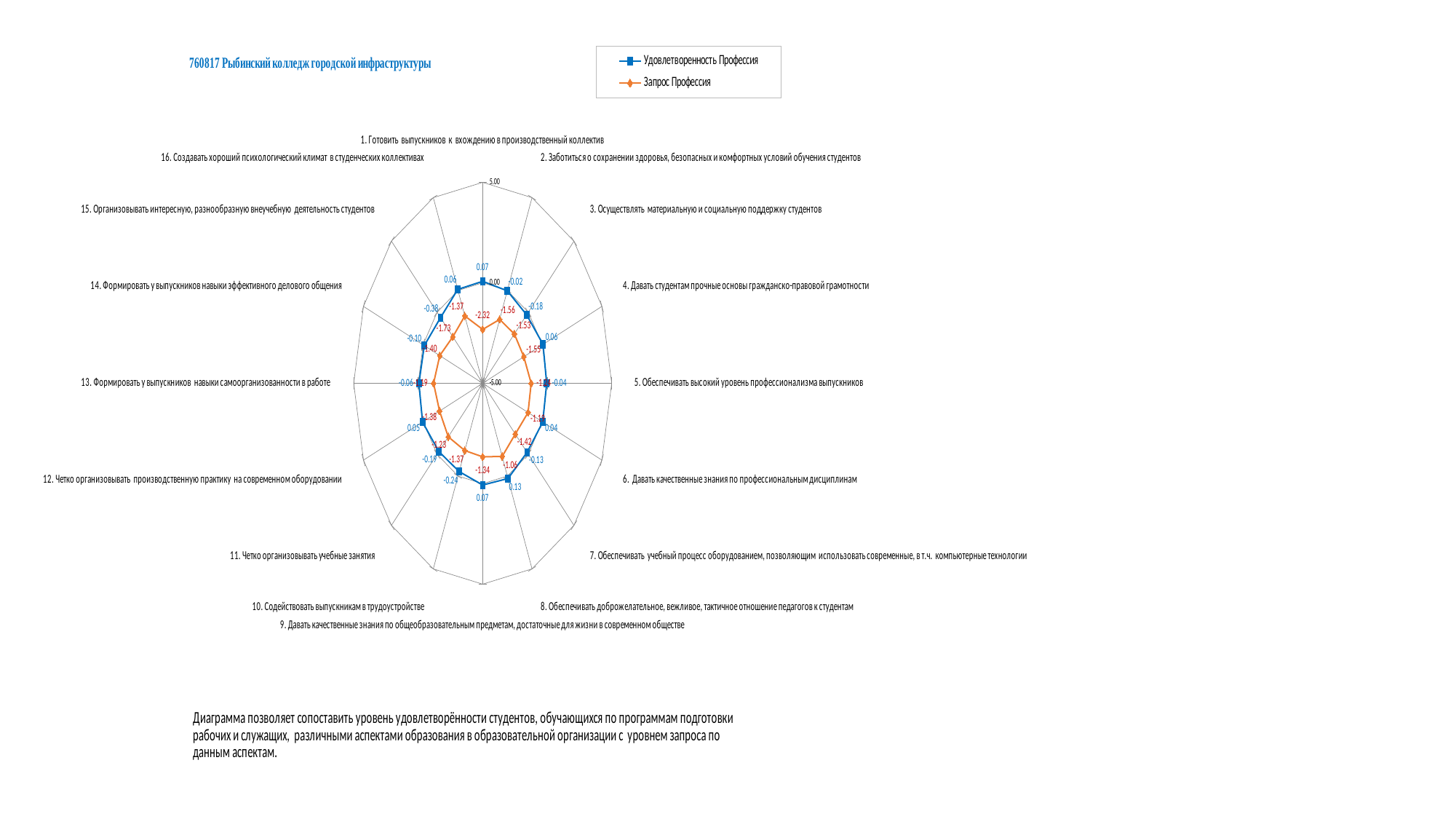
What is the value of the 'Удовлетворенность Профессия' series for category 1 (Готовить выпускников к вхождению в производственный коллектив)? 0.07 How many series does the legend list? 2 How many categories (axes) does the radar chart have? 16 Which category has the lowest value in the 'Запрос Профессия' series? 1. Готовить выпускников к вхождению в производственный коллектив What is the title of the chart? 760817 Рыбинский колледж городской инфраструктуры For category 1, which series has the larger value: 'Удовлетворенность Профессия' or 'Запрос Профессия'? Удовлетворенность Профессия What is the value of the 'Запрос Профессия' series for category 1 (Готовить выпускников к вхождению в производственный коллектив)? -2.32 What is the value of the 'Запрос Профессия' series for category 15 (Организовывать интересную, разнообразную внеучебную деятельность студентов)? -1.73 What is the value of the 'Удовлетворенность Профессия' series for category 10 (Содействовать выпускникам в трудоустройстве)? -0.24 Which category has the lowest value in the 'Удовлетворенность Профессия' series? 15. Организовывать интересную, разнообразную внеучебную деятельность студентов What kind of chart is shown on the slide? Radar chart Which category has the highest value in the 'Запрос Профессия' series? 8. Обеспечивать доброжелательное, вежливое, тактичное отношение педагогов к студентам